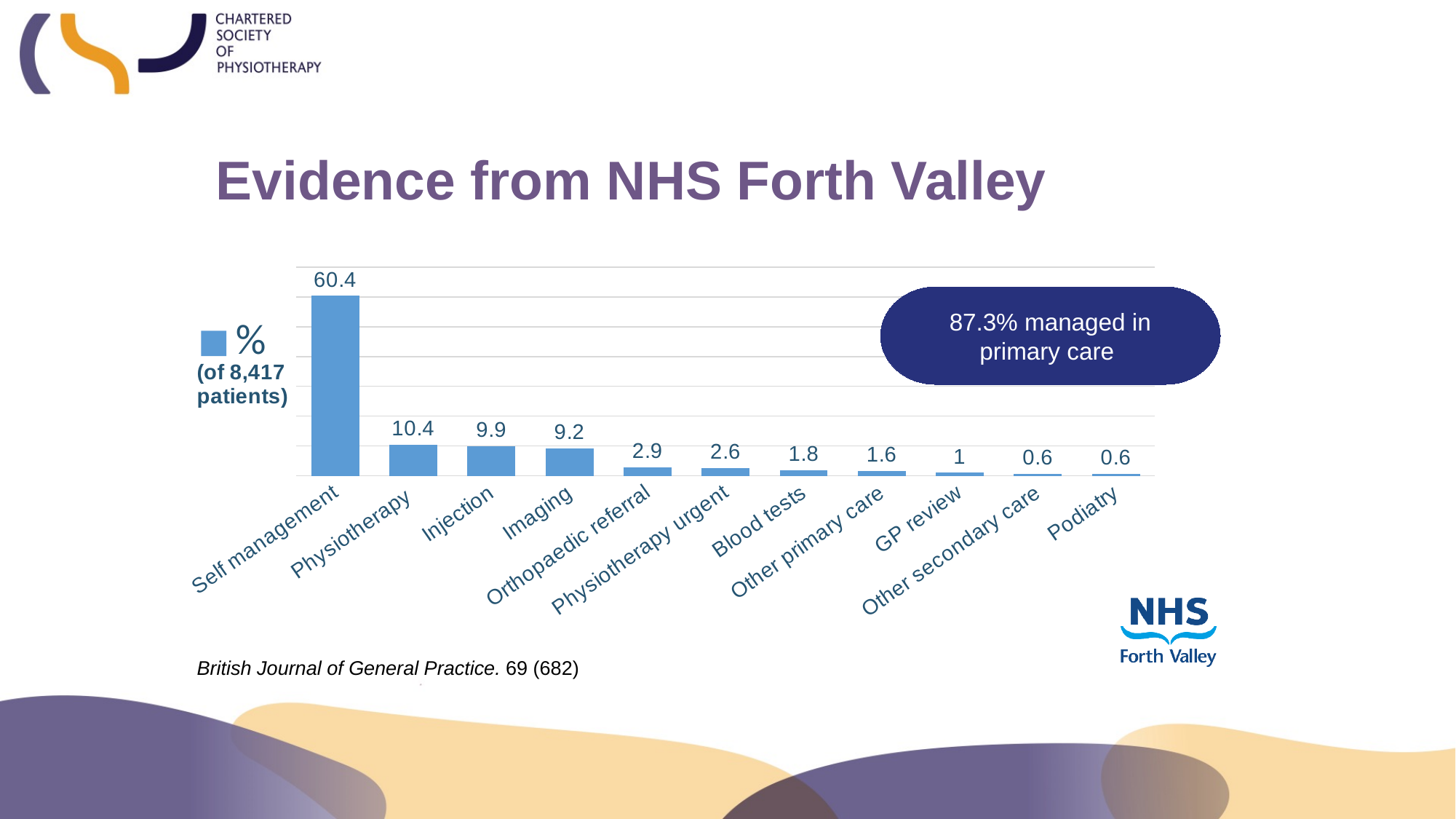
What is the value for Physiotherapy? 10.4 Which category has the highest value? Self management What is the value for Orthopaedic referral? 2.9 What is the name of the series shown in the legend? % What is the difference between the values for Self management and Imaging? 51.2 Which is larger, the value for Blood tests or the value for Other primary care? Blood tests What is the value for Self management? 60.4 What is the difference between the values for Physiotherapy and Injection? 0.5 How many categories are shown on the x axis? 11 Do the values rise or fall from left to right along the x axis? Fall What is the value for GP review? 1 What kind of chart is shown on the slide? Bar chart